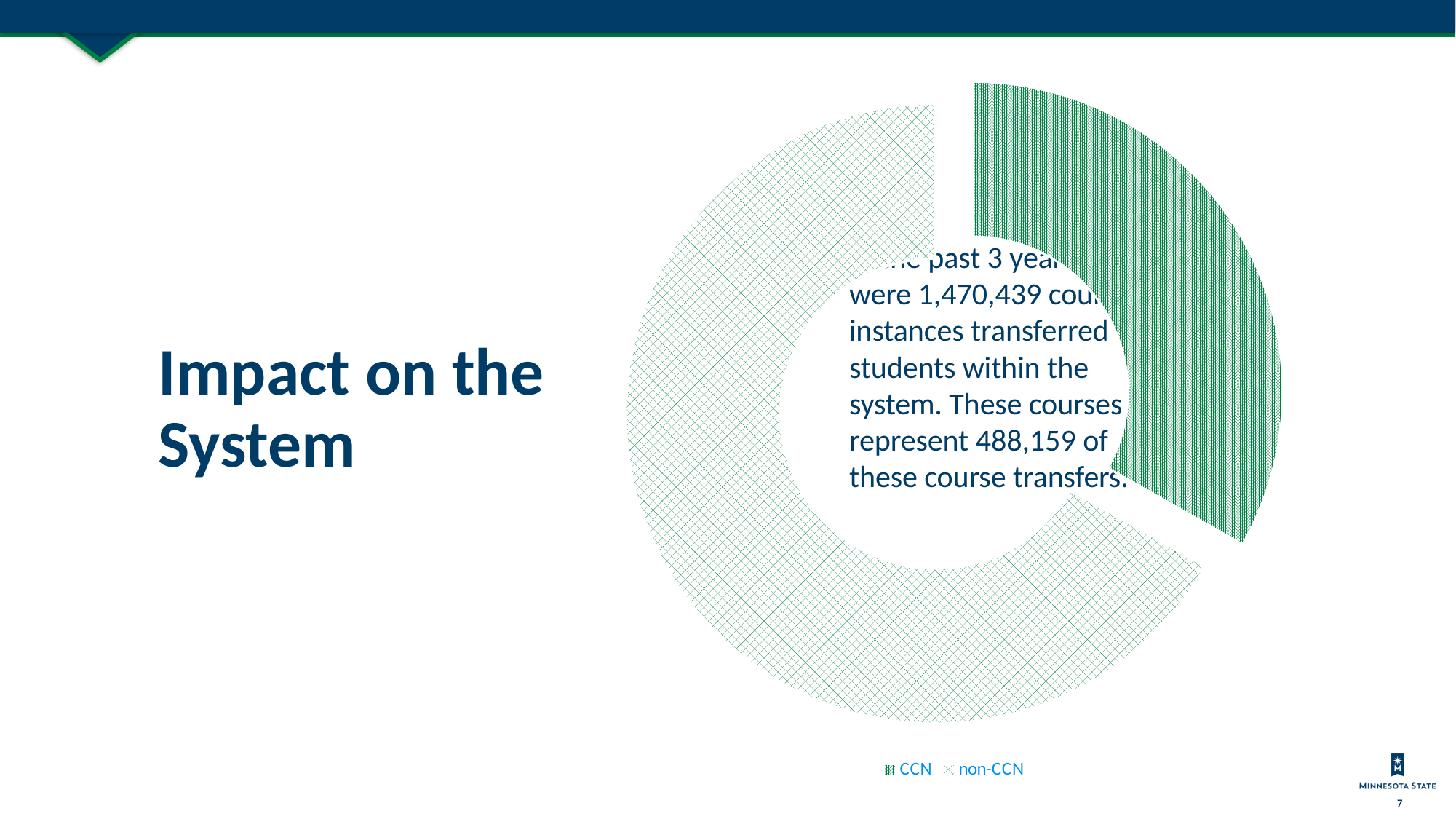
Which category has the largest slice in the doughnut chart? non-CCN Which legend entry is shown with the crosshatch pattern? non-CCN Which legend entry is shown with the solid green fill pattern? CCN How many entries does the chart legend list? 2 Which category has the smallest slice in the doughnut chart? CCN Is the CCN slice greater or less than half of the doughnut? less Which slice is larger, CCN or non-CCN? non-CCN How many slices does the doughnut chart have? 2 What kind of chart is shown on the slide? Doughnut chart